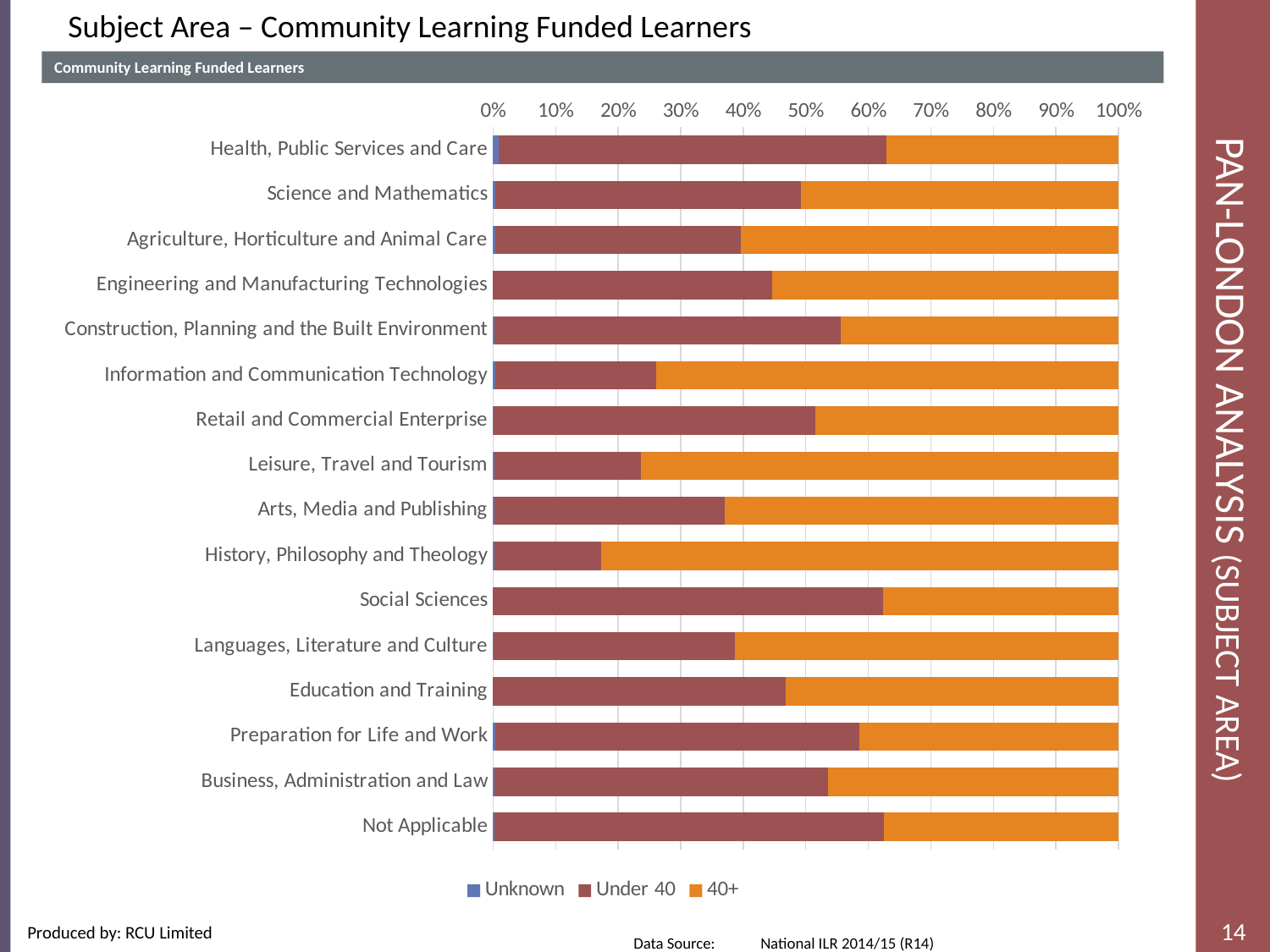
Is the Under 40 share for Information and Communication Technology greater or less than 30%? less Which has the larger Under 40 share: Health, Public Services and Care or Leisure, Travel and Tourism? Health, Public Services and Care Is the Under 40 share for Health, Public Services and Care greater or less than 60%? greater Which subject area has the highest 40+ share? History, Philosophy and Theology What kind of chart is shown on the slide? Stacked bar chart Is the Under 40 share for Leisure, Travel and Tourism greater or less than 30%? less Which has the larger Under 40 share: Construction, Planning and the Built Environment or Information and Communication Technology? Construction, Planning and the Built Environment Which subject area has the lowest Under 40 share? History, Philosophy and Theology What are the three series named in the legend? Unknown, Under 40, 40+ How many series does the chart's legend list? 3 What is the title shown in the chart's header bar? Community Learning Funded Learners How many subject area categories are plotted on the chart? 16